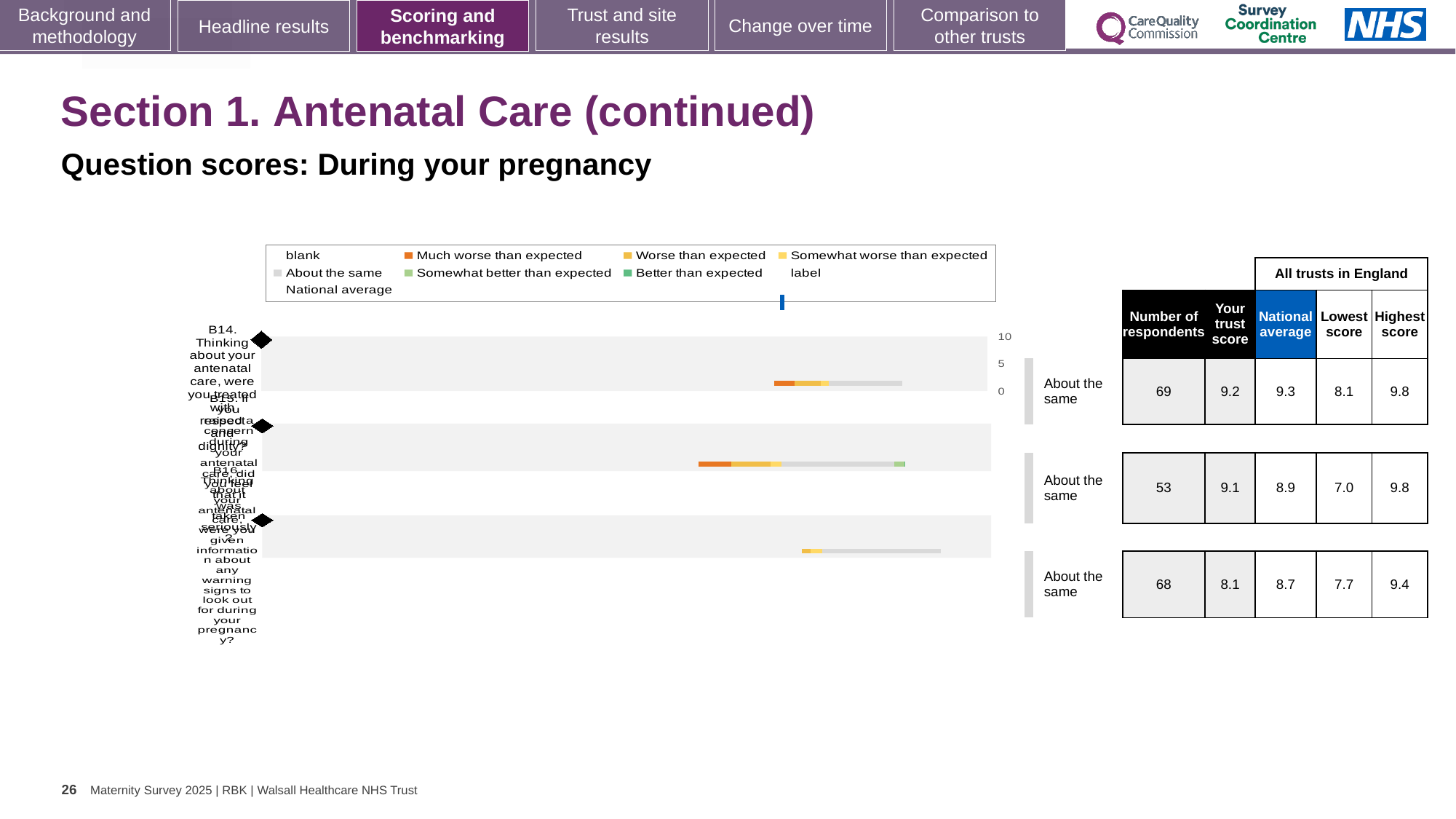
What is the subtitle above the chart? Question scores: During your pregnancy In the table beside the chart, what is the trust score for the second question (B15)? 9.1 In the table beside the chart, which question has the lowest trust score? B16 In the table beside the chart, what is the number of respondents for the first question (B14)? 69 In the table beside the chart, what is the difference between the highest score and the lowest score for the second question (B15)? 2.8 In the table beside the chart, what is the national average for the third question (B16)? 8.7 In the table beside the chart, is the trust score for the first question (B14) larger or smaller than its national average? smaller Which legend entry is shown in dark orange? Much worse than expected How many question bars are plotted in the chart? 3 In the table beside the chart, what is the lowest score across all trusts for the third question (B16)? 7.7 What benchmark category is shown beside the bar for B14? About the same What kind of chart is shown on the slide? bar chart